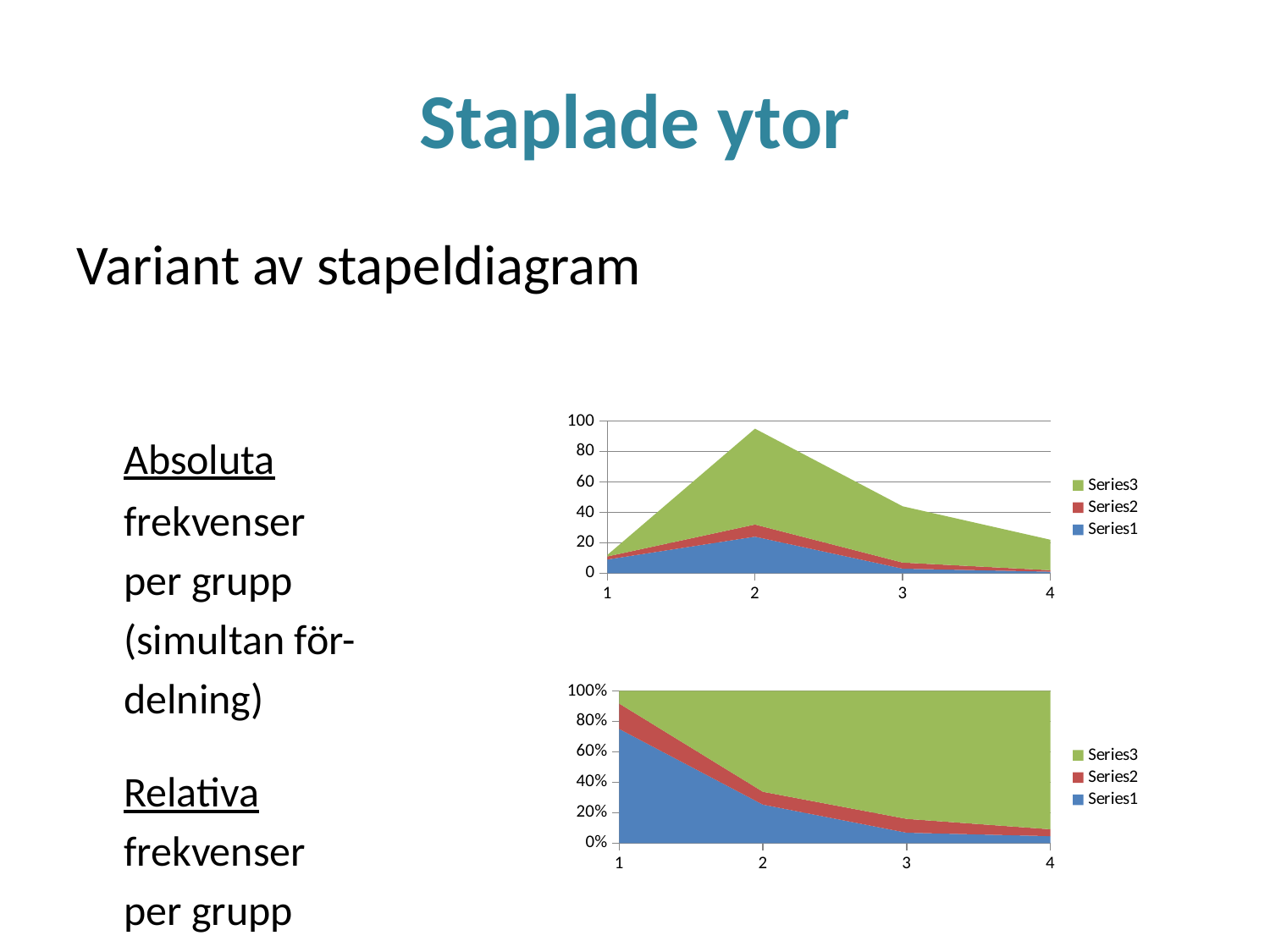
In the top chart, which has the larger stacked total, category 3 or category 4? category 3 What kind of chart is the top chart on the slide? stacked area chart In the top chart, which category has the lowest stacked total? 1 How many series does the legend of the top chart list? 3 In the top chart, is the stacked total at category 4 greater or less than 40? less What are the legend entries of the bottom chart? Series3, Series2, Series1 In the top chart, is the stacked total at category 2 greater or less than 80? greater How many categories are shown on the x axis of the bottom chart? 4 In the top chart, which category has the highest stacked total? 2 In the bottom chart, does the share of Series1 rise or fall from category 1 to category 4? fall In the bottom chart, is the share of Series1 at category 4 greater or less than 20%? less